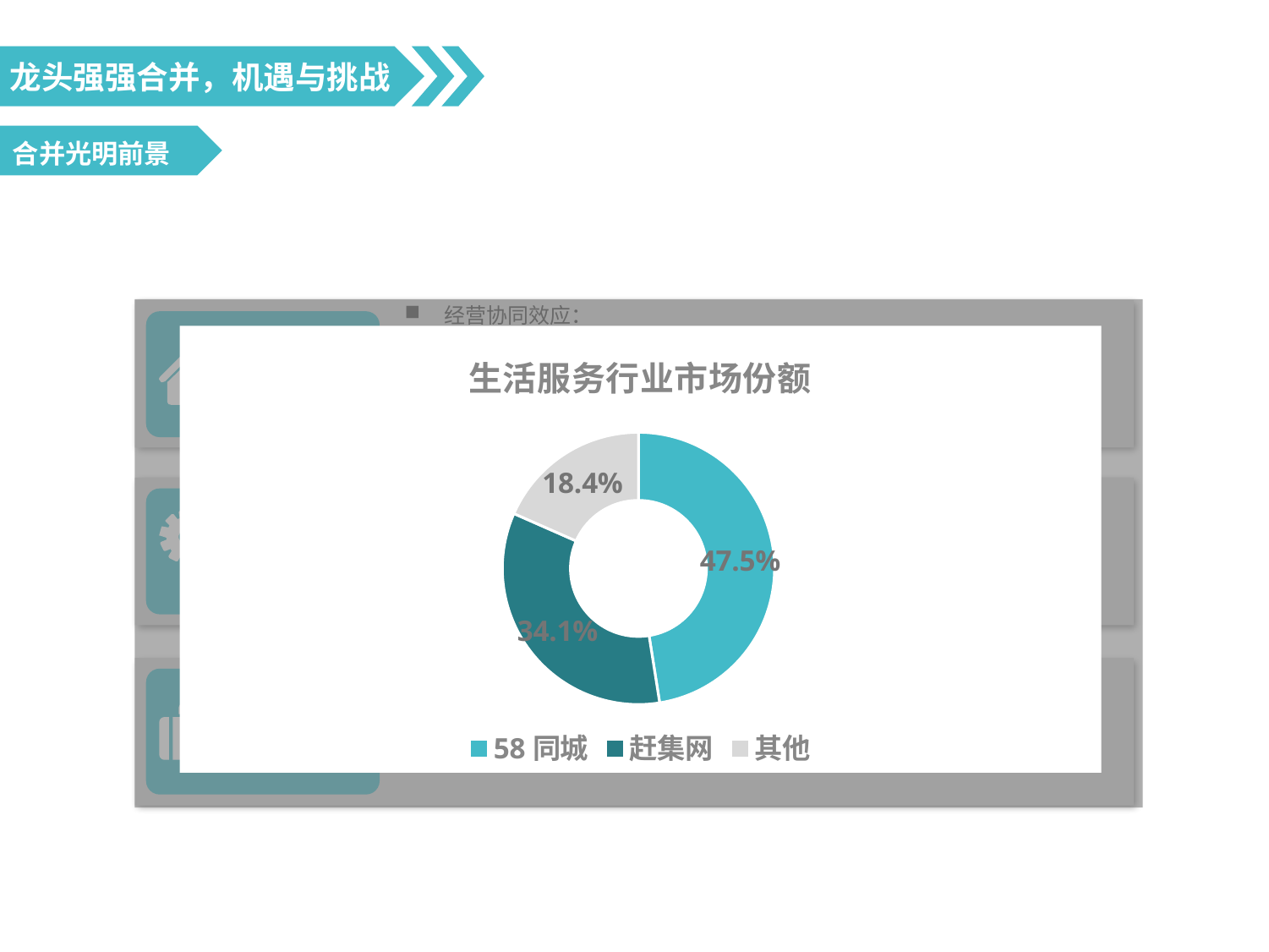
What is the title of the chart? 生活服务行业市场份额 What is the difference in percentage points between the shares of 58 同城 and 赶集网? 13.4 Which has a larger share, 赶集网 or 其他? 赶集网 What is the market share shown for 58 同城? 47.5% What kind of chart is shown on the slide? Doughnut (pie) chart What is the market share shown for 赶集网? 34.1% What is the combined share of 58 同城 and 赶集网? 81.6% How many categories are shown in the chart? 3 Which category has the largest share in the chart? 58 同城 Which category has the smallest share in the chart? 其他 What is the market share shown for 其他? 18.4% What is the difference in percentage points between the shares of 赶集网 and 其他? 15.7